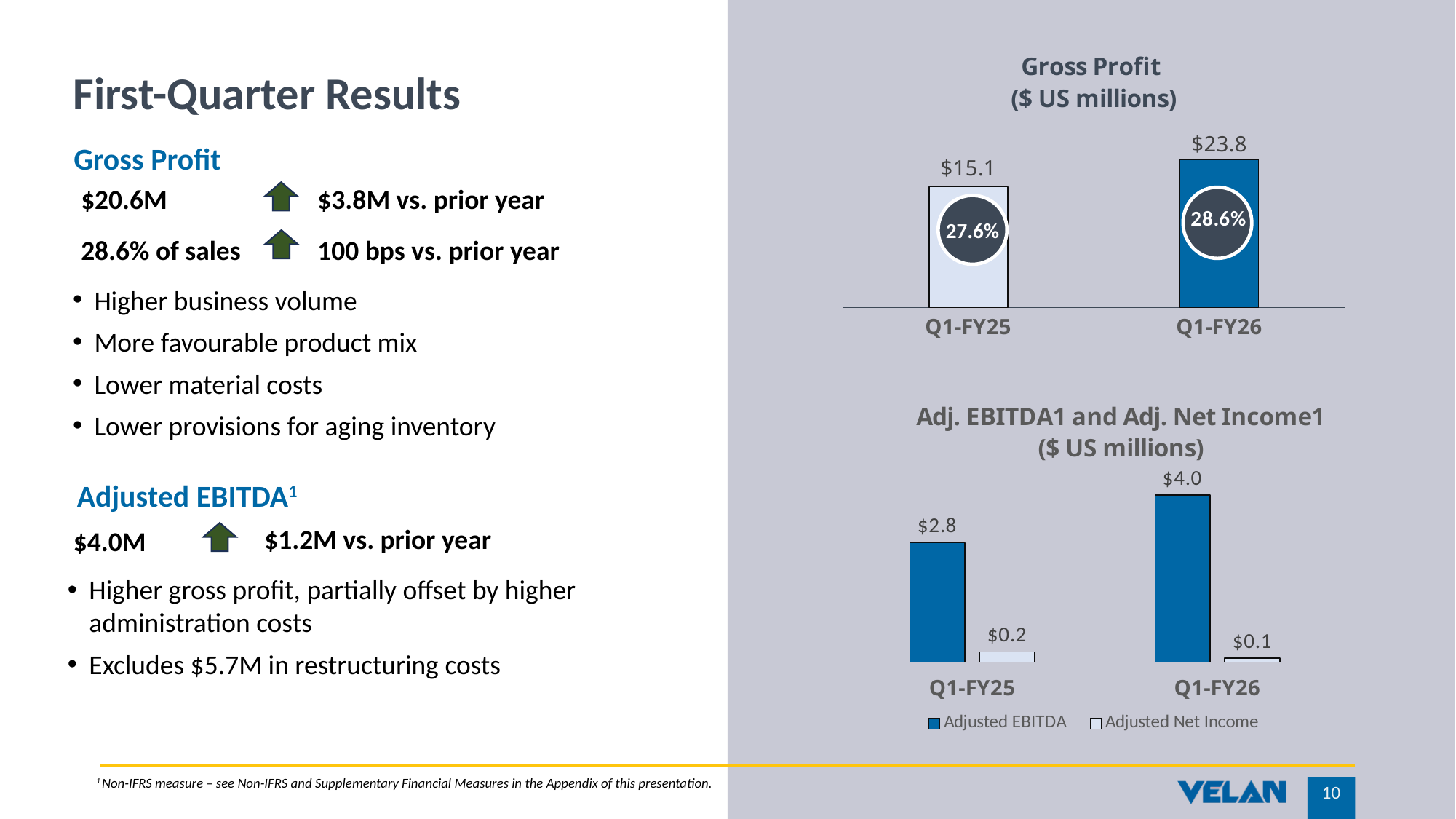
In the Adj. EBITDA and Adj. Net Income chart, what is the difference in Adjusted EBITDA between Q1-FY26 and Q1-FY25? $1.2 In the Adj. EBITDA and Adj. Net Income chart, how many series does the legend list? 2 In the Gross Profit chart, what percentage is shown inside the Q1-FY25 bar? 27.6% In the Adj. EBITDA and Adj. Net Income chart, is Adjusted Net Income higher in Q1-FY25 or Q1-FY26? Q1-FY25 What type of chart is the Gross Profit chart? Bar chart In the Gross Profit chart, what is the difference in gross profit between Q1-FY26 and Q1-FY25? $8.7 In the Gross Profit chart, which quarter has the higher gross profit? Q1-FY26 In the Gross Profit chart, what is the gross profit value for Q1-FY25? $15.1 In the Adj. EBITDA and Adj. Net Income chart, what is the Adjusted Net Income for Q1-FY25? $0.2 In the Gross Profit chart, what percentage is shown inside the Q1-FY26 bar? 28.6% In the Adj. EBITDA and Adj. Net Income chart, what is the Adjusted EBITDA for Q1-FY26? $4.0 In the Gross Profit chart, what is the gross profit value for Q1-FY26? $23.8